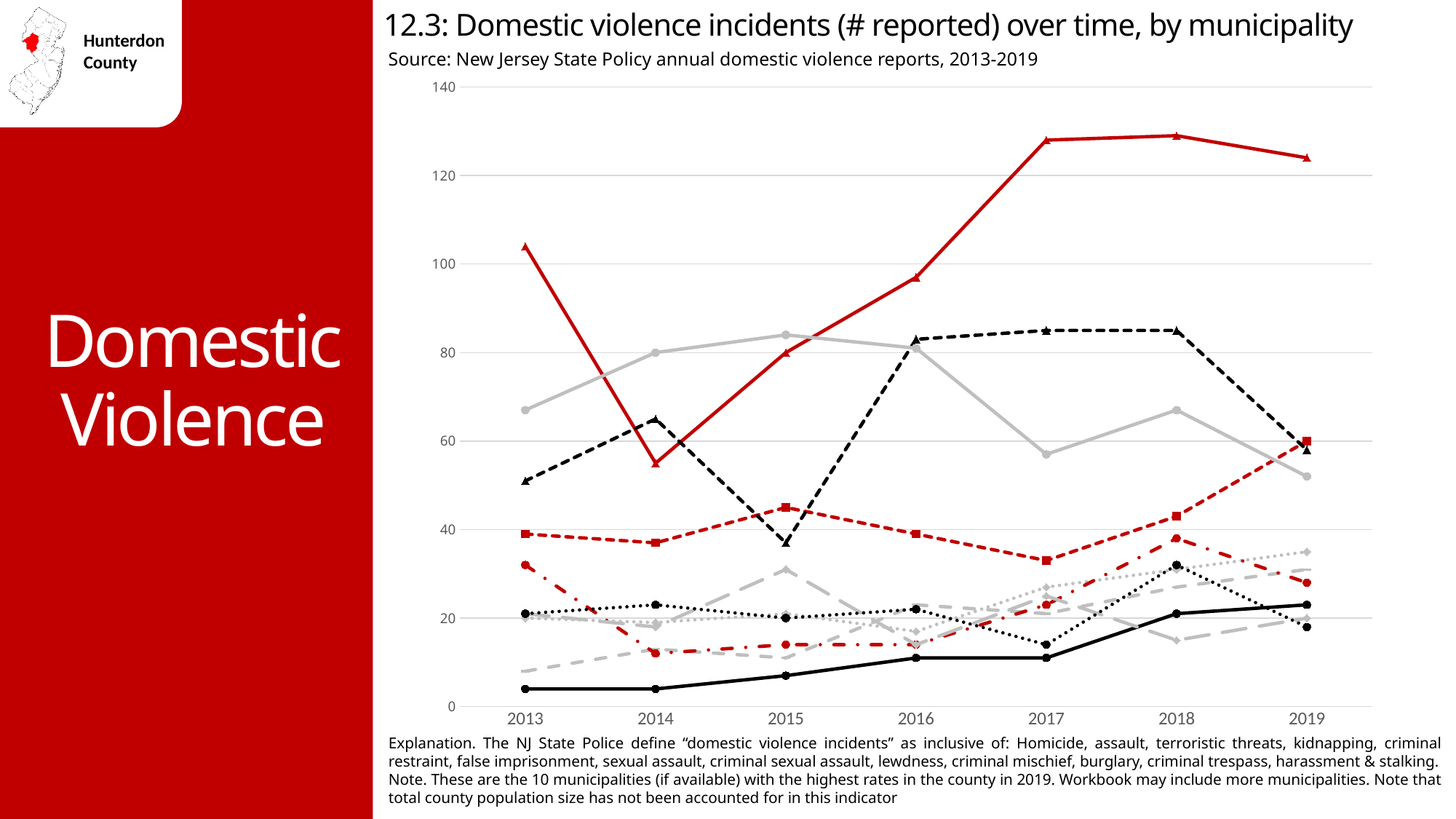
Is the value of the solid red line in 2013 greater or less than 100? greater Is the value of the black dashed line with triangle markers in 2018 greater or less than 80? greater Is the value of the solid red line in 2014 greater or less than 60? less What is the title of the chart? 12.3: Domestic violence incidents (# reported) over time, by municipality How many years are shown along the x axis of the chart? 7 In 2019, which is larger: the solid red line or the solid grey line? the solid red line Does the solid black line rise or fall from 2013 to 2019? rise What is the highest value shown on the y axis of the chart? 140 What kind of chart is shown on the slide? line chart